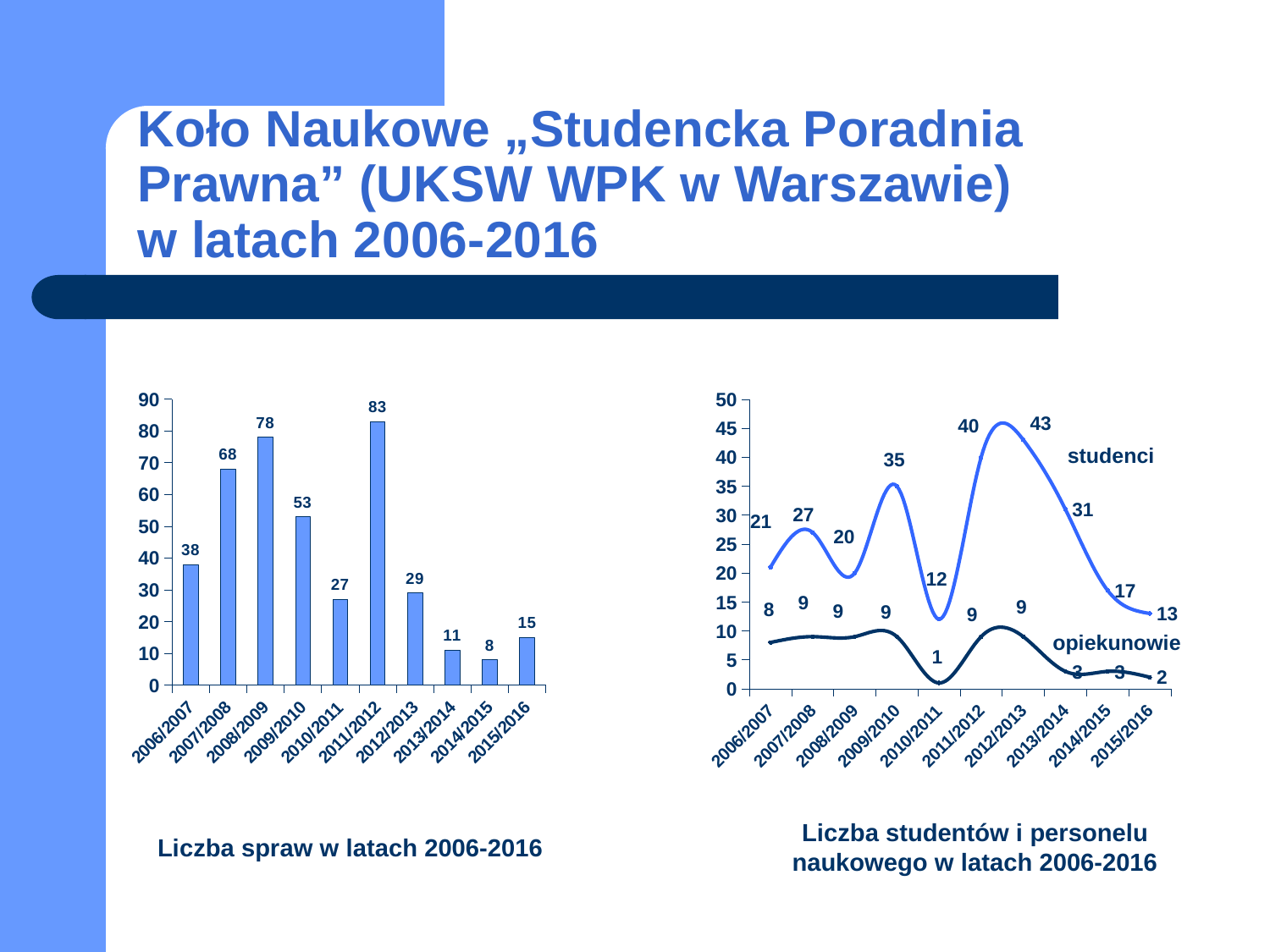
In the chart titled "Liczba spraw w latach 2006-2016", what is the difference between the values for 2008/2009 and 2009/2010? 25 In the chart titled "Liczba spraw w latach 2006-2016", which year has the highest value? 2011/2012 What kind of chart is the one titled "Liczba studentów i personelu naukowego w latach 2006-2016"? line chart In the chart titled "Liczba studentów i personelu naukowego w latach 2006-2016", which year has the highest value for studenci? 2012/2013 In the chart titled "Liczba studentów i personelu naukowego w latach 2006-2016", how many series are plotted? 2 In the chart titled "Liczba studentów i personelu naukowego w latach 2006-2016", is the value for studenci in 2009/2010 larger than the value for studenci in 2010/2011? Yes, 35 is larger than 12 In the chart titled "Liczba spraw w latach 2006-2016", what is the value for 2011/2012? 83 In the chart titled "Liczba studentów i personelu naukowego w latach 2006-2016", what is the value for studenci in 2012/2013? 43 What kind of chart is the one titled "Liczba spraw w latach 2006-2016"? bar chart In the chart titled "Liczba studentów i personelu naukowego w latach 2006-2016", what is the value for opiekunowie in 2010/2011? 1 In the chart titled "Liczba spraw w latach 2006-2016", which year has the lowest value? 2014/2015 In the chart titled "Liczba spraw w latach 2006-2016", how many years are shown on the x axis? 10